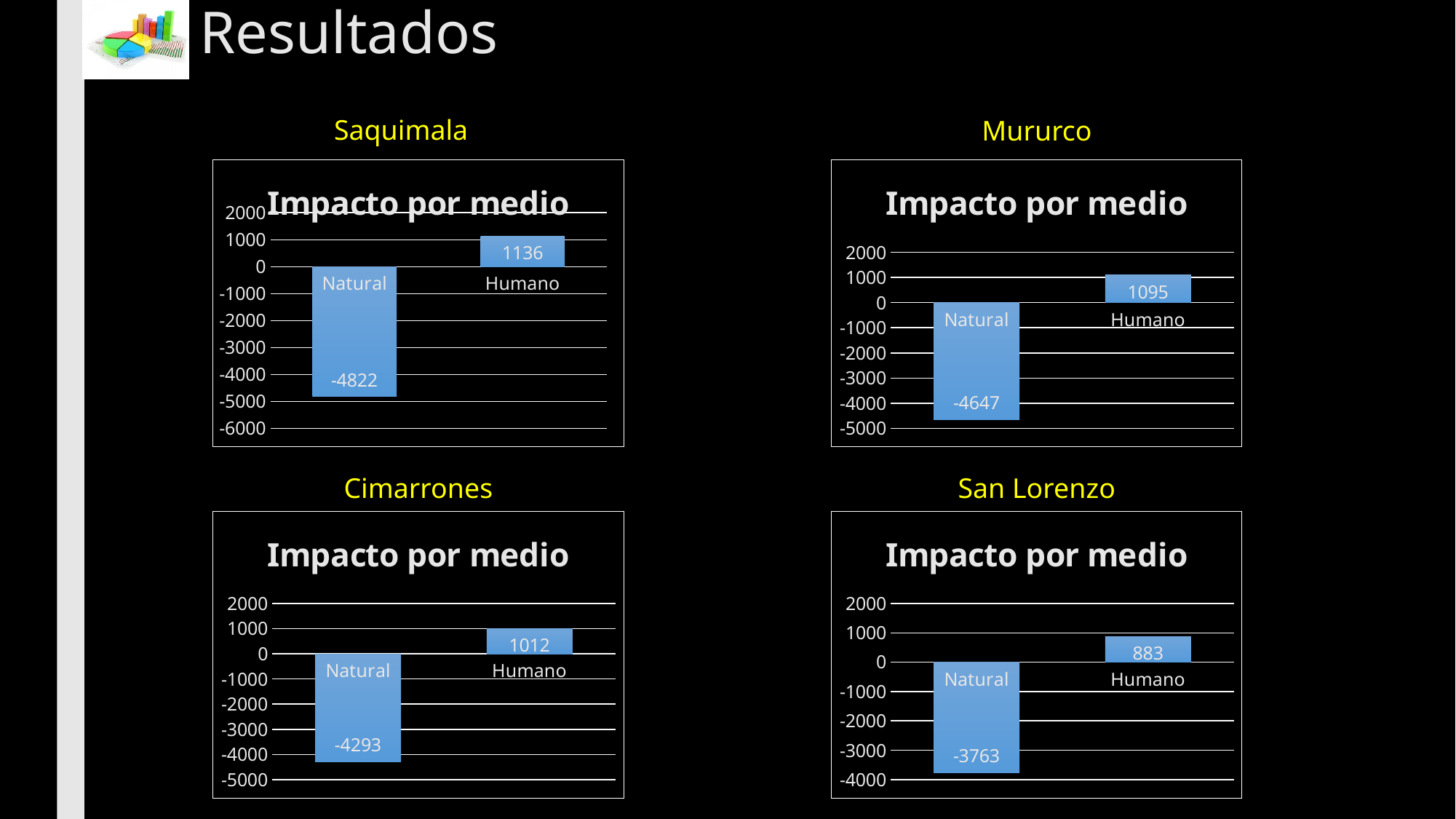
In the Cimarrones chart, what is the value for Natural? -4293 In the Saquimala chart, which category has the higher value, Natural or Humano? Humano In the San Lorenzo chart, what is the value for Humano? 883 In the Saquimala chart, what is the value for Humano? 1136 In the Cimarrones chart, what is the difference between the Humano value and the Natural value? 5305 In the Mururco chart, what is the value for Humano? 1095 What is the title of the chart under Cimarrones? Impacto por medio How many categories are shown in the Mururco chart? 2 In the San Lorenzo chart, what is the value for Natural? -3763 In the Mururco chart, what is the value for Natural? -4647 What type of chart is the San Lorenzo chart? Bar chart In the Saquimala chart, what is the value for Natural? -4822